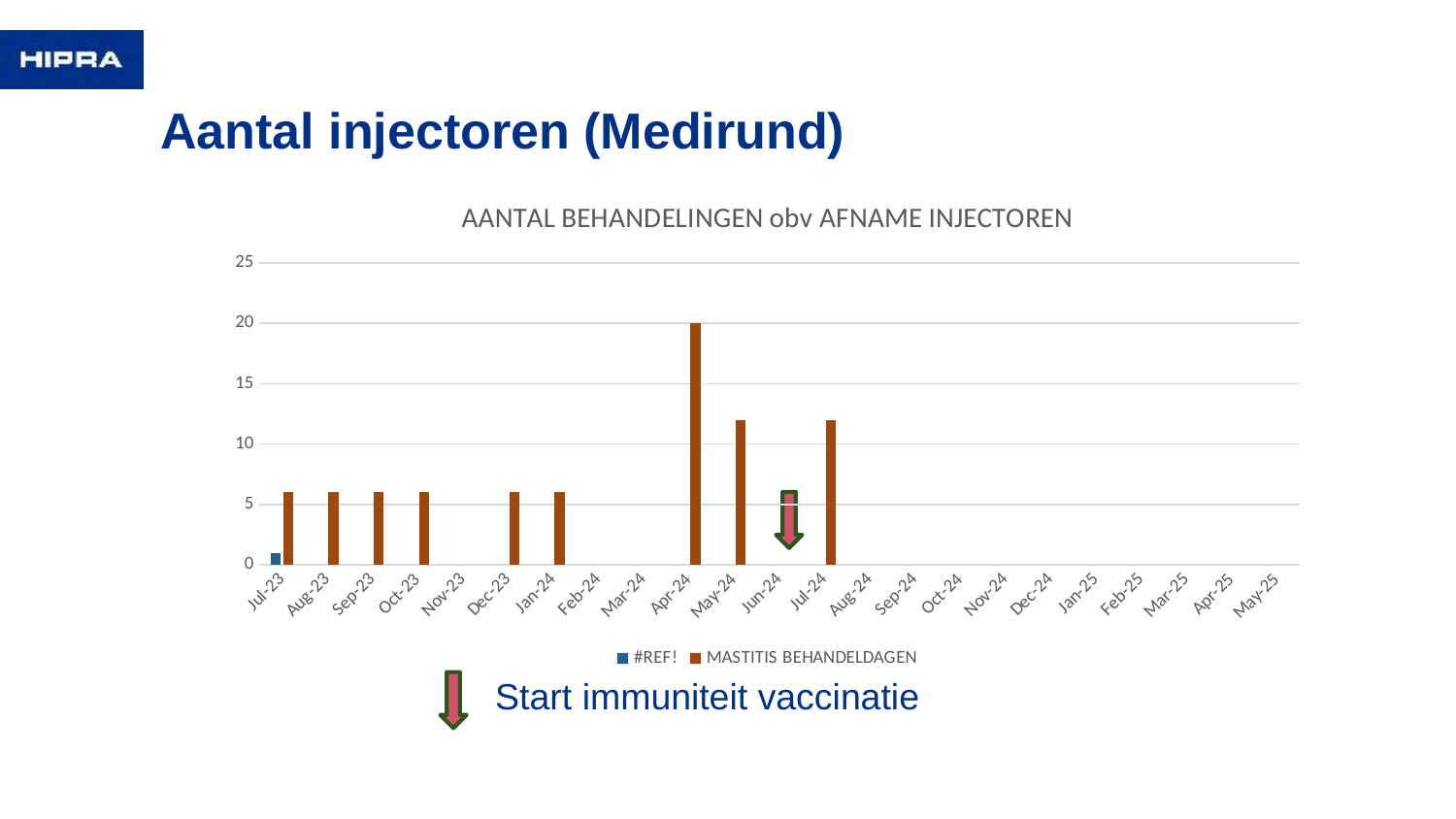
What is the title of the chart? AANTAL BEHANDELINGEN obv AFNAME INJECTOREN Which month has the highest value for MASTITIS BEHANDELDAGEN? Apr-24 What are the two legend entries of the chart? #REF! and MASTITIS BEHANDELDAGEN Is the value for MASTITIS BEHANDELDAGEN in Aug-23 greater or less than 10? less Is the value for MASTITIS BEHANDELDAGEN in May-24 greater or less than 10? greater How many series does the legend list? 2 Which is larger, the MASTITIS BEHANDELDAGEN value for Apr-24 or for Jul-24? Apr-24 How many months are shown on the x axis of the chart? 23 What is the value for MASTITIS BEHANDELDAGEN in Apr-24? 20 What type of chart is shown on the slide? bar chart